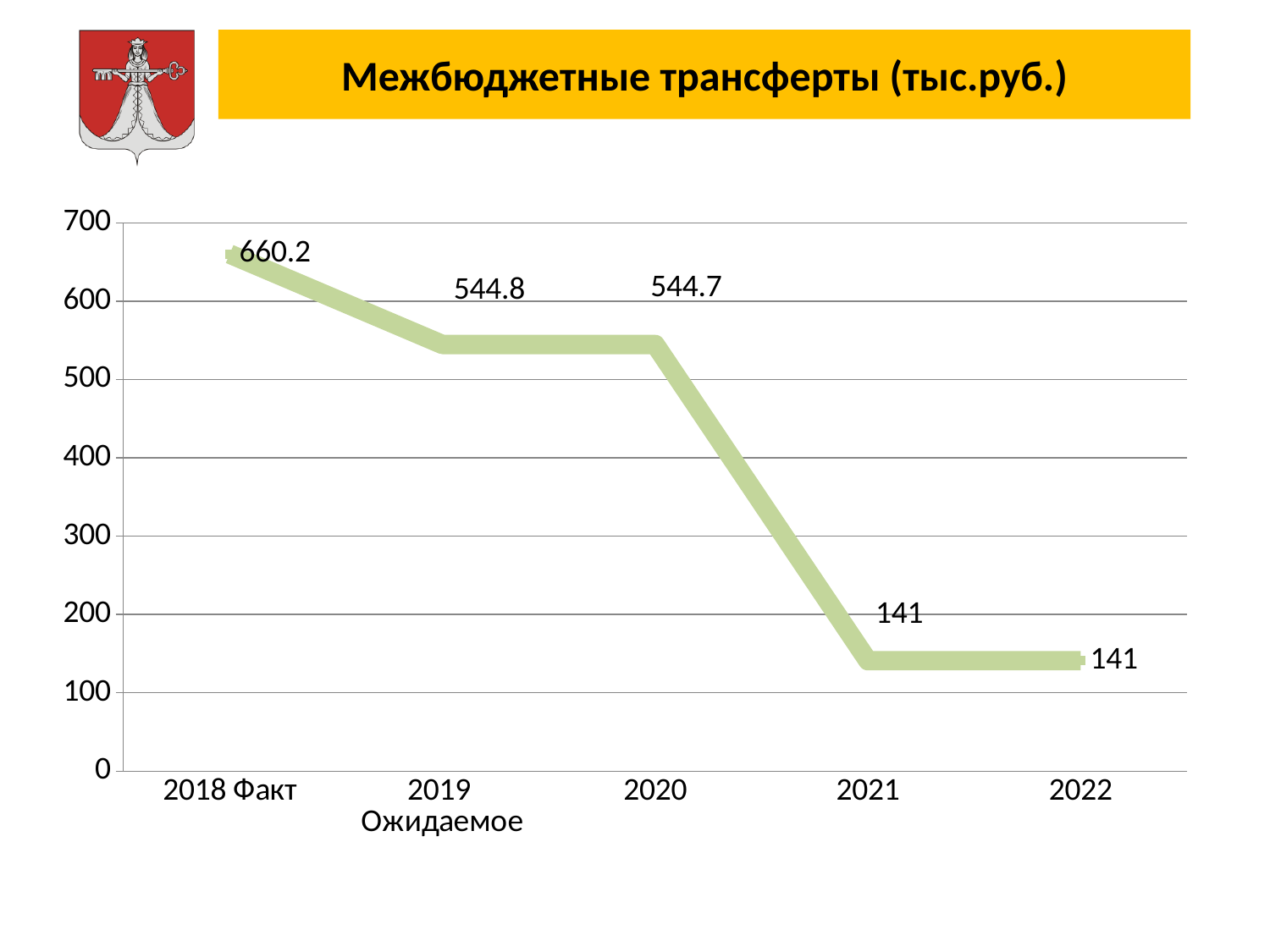
What kind of chart is this? line chart Which category has the highest value? 2018 Факт What is the title of the chart? Межбюджетные трансферты (тыс.руб.) What is the value for 2020? 544.7 What is the value for 2022? 141 Which is larger, the value for 2019 Ожидаемое or the value for 2021? 2019 Ожидаемое What is the value for 2018 Факт? 660.2 What is the difference between the values for 2020 and 2021? 403.7 What is the value for 2019 Ожидаемое? 544.8 How many categories are shown on the x axis? 5 What is the difference between the values for 2018 Факт and 2019 Ожидаемое? 115.4 Do the values rise or fall from 2018 Факт to 2022? fall